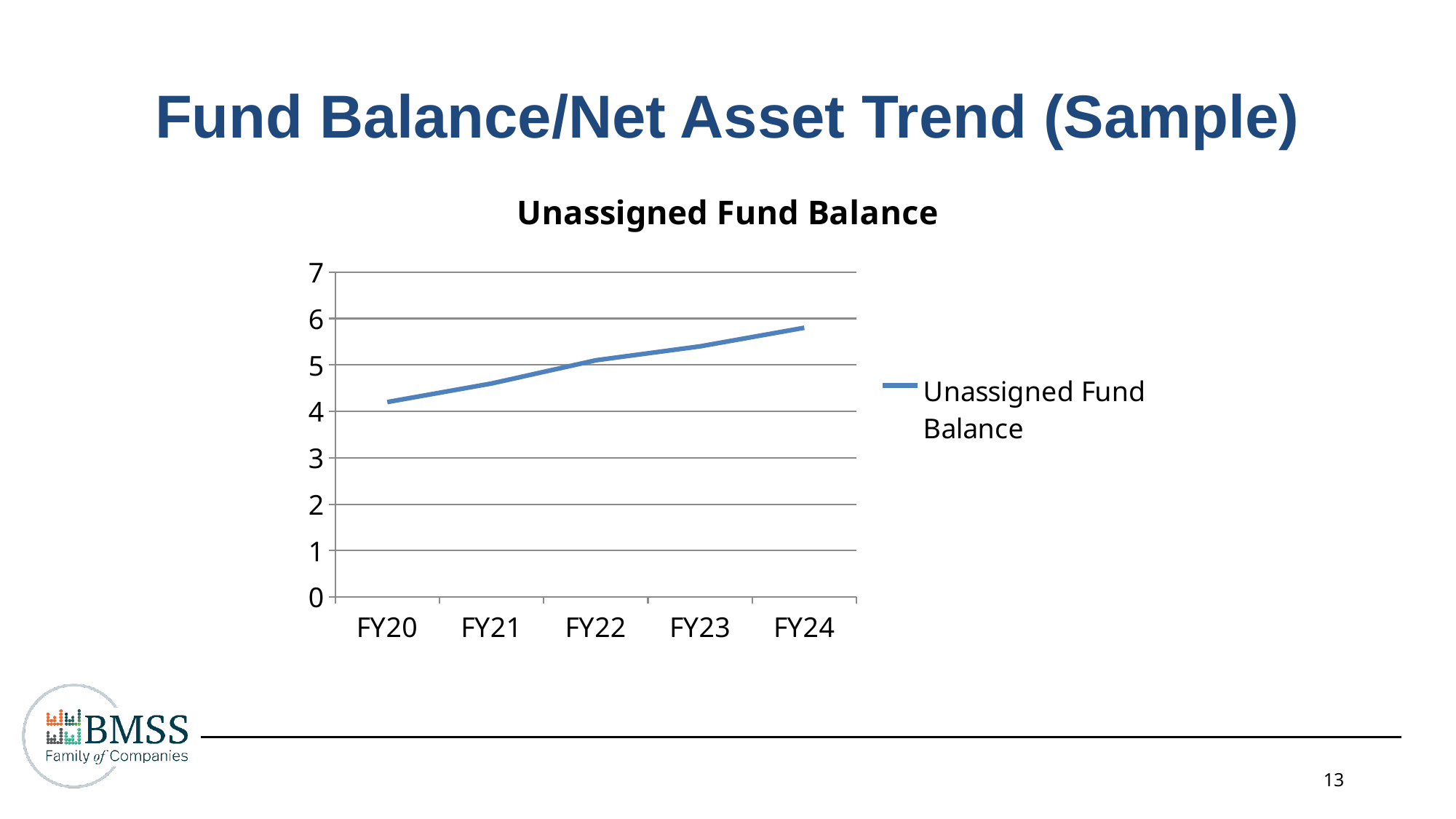
Which fiscal year has the lowest Unassigned Fund Balance? FY20 How many fiscal years are plotted on the x axis? 5 Do the values rise or fall from FY20 to FY24? rise Is the value for FY20 greater or less than 4? greater Is the value for FY23 greater or less than 5? greater Which fiscal year has the highest Unassigned Fund Balance? FY24 Which is larger, the value for FY20 or the value for FY24? FY24 What kind of chart is shown on the slide? line chart Is the value for FY21 greater or less than 5? less How many series does the legend list? 1 What is the title of the chart? Unassigned Fund Balance